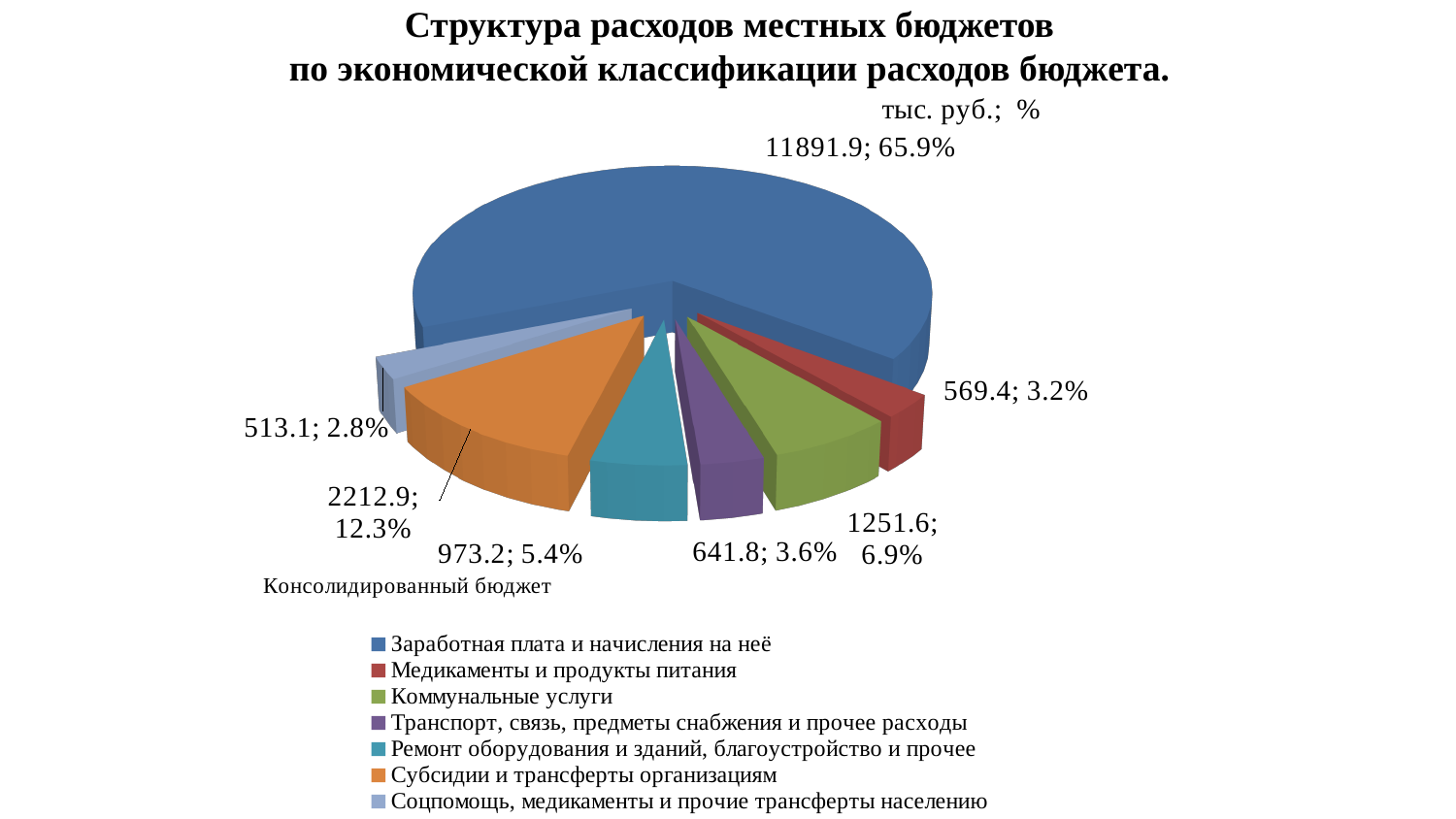
What kind of chart is shown on the slide? pie chart How many slices does the pie chart have? 7 What is the difference in thousand rubles between "Субсидии и трансферты организациям" and "Коммунальные услуги"? 961.3 What value in thousand rubles is shown for "Заработная плата и начисления на неё"? 11891.9 What value in thousand rubles is shown for "Коммунальные услуги"? 1251.6 Which category has the smallest share of the pie? Соцпомощь, медикаменты и прочие трансферты населению What percentage share does "Соцпомощь, медикаменты и прочие трансферты населению" have? 2.8% What is the title of the chart? Структура расходов местных бюджетов по экономической классификации расходов бюджета. Which is larger: "Ремонт оборудования и зданий, благоустройство и прочее" or "Транспорт, связь, предметы снабжения и прочее расходы"? Ремонт оборудования и зданий, благоустройство и прочее How many entries does the legend list? 7 Which category has the largest share of the pie? Заработная плата и начисления на неё What percentage share does "Субсидии и трансферты организациям" have? 12.3%